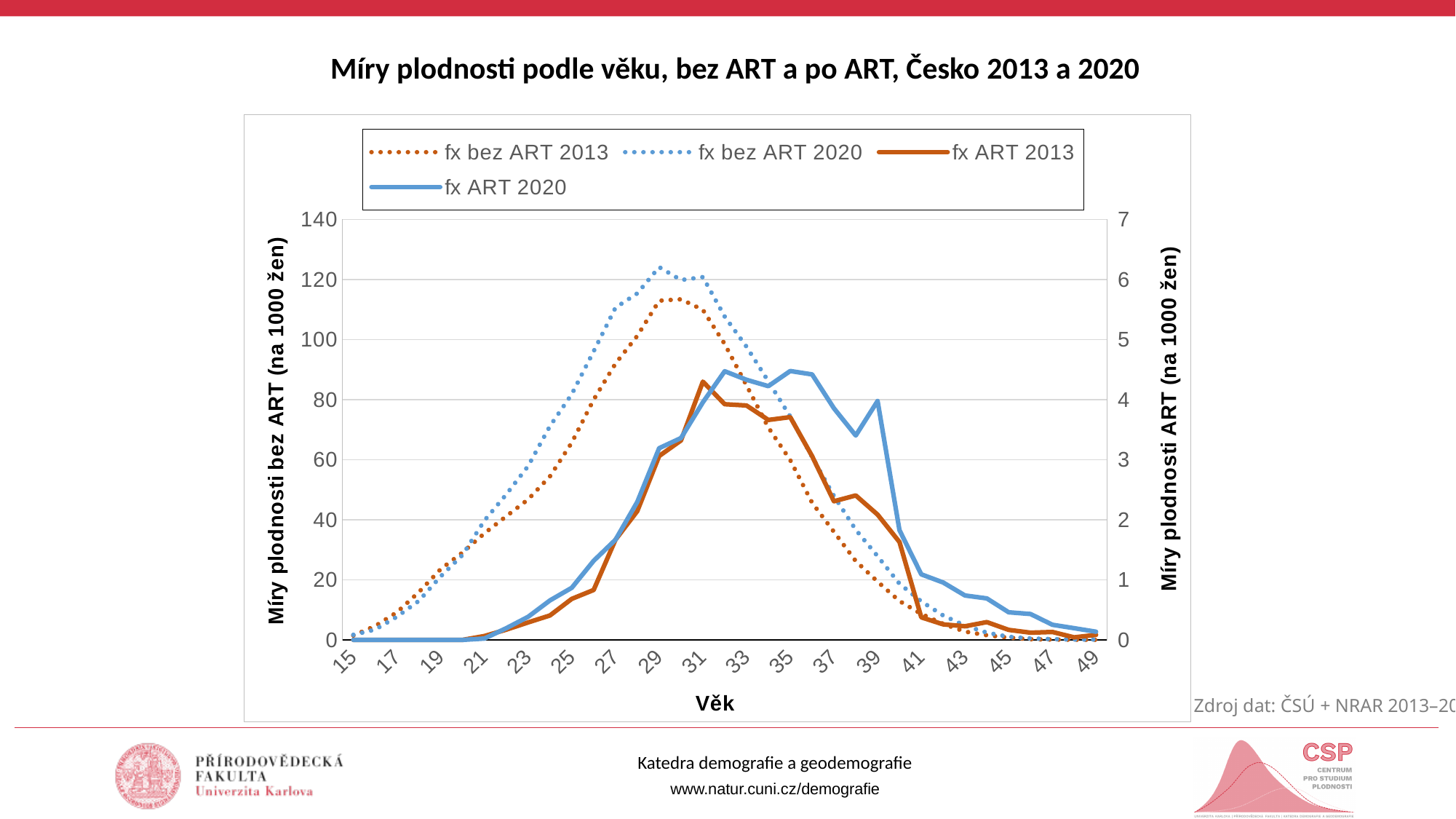
At age 39, which is higher: fx ART 2013 or fx ART 2020? fx ART 2020 Does fx bez ART 2013 rise or fall between age 31 and age 49? fall Is the value of fx bez ART 2013 at age 30 greater or less than 100 on the left-hand axis? greater What is the label of the x axis? Věk Is the peak value of fx bez ART 2020 greater or less than 120 on the left-hand axis? greater Is the peak value of fx bez ART 2013 greater or less than 120 on the left-hand axis? less Which series reaches the highest peak on the left-hand axis? fx bez ART 2020 At age 25, which is higher: fx bez ART 2013 or fx bez ART 2020? fx bez ART 2020 How many series does the legend list? 4 What kind of chart is shown on the slide? line chart What is the title of the chart? Míry plodnosti podle věku, bez ART a po ART, Česko 2013 a 2020 How many age labels are printed along the x axis? 18